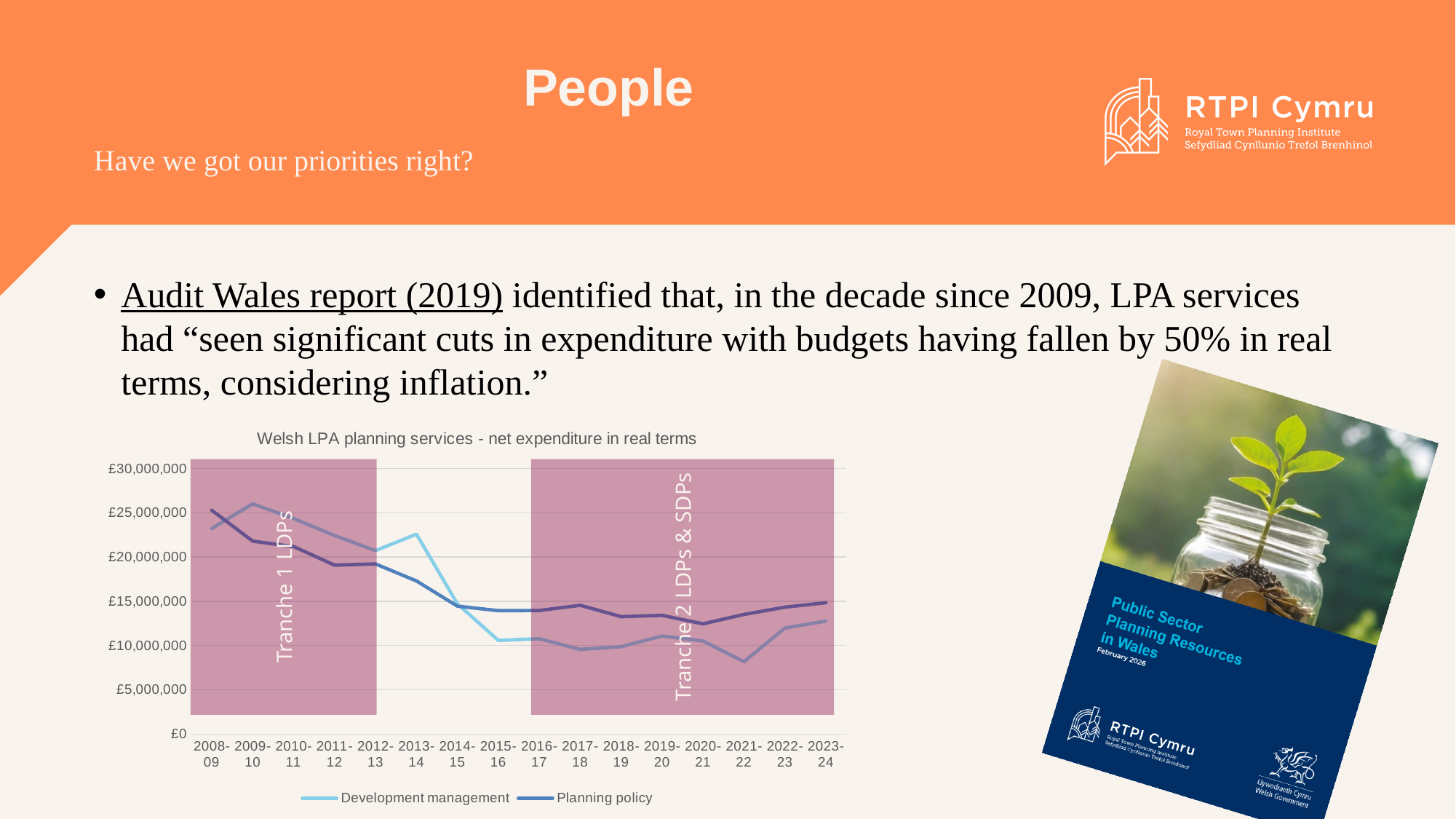
What kind of chart is shown on the slide? Line chart How many series does the chart's legend list? 2 Is the value for Development management in 2021-22 greater or less than £10,000,000? less In which year is the Development management series at its highest? 2009-10 In which year is the Development management series at its lowest? 2021-22 Is the value for Development management in 2009-10 greater or less than £25,000,000? greater Does the Planning policy series rise or fall between 2008-09 and 2014-15? Fall How many financial years are plotted along the x axis of the chart? 16 What is the title of the chart? Welsh LPA planning services - net expenditure in real terms In 2021-22, which series has the larger value: Development management or Planning policy? Planning policy Is the value for Planning policy in 2023-24 greater or less than £10,000,000? greater In 2013-14, which series has the larger value: Development management or Planning policy? Development management